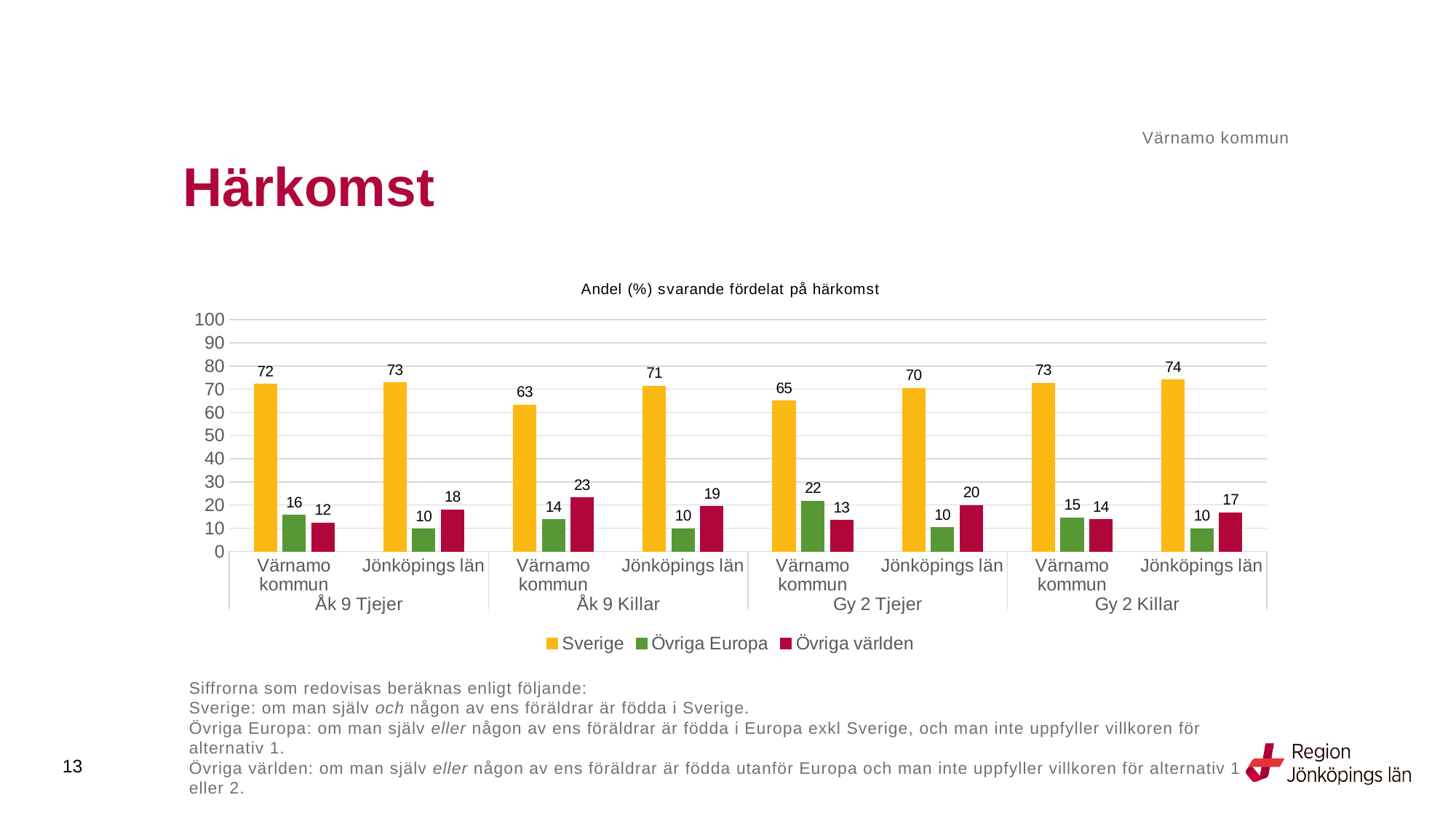
Which category has the lowest Sverige value? Värnamo kommun (Åk 9 Killar) What kind of chart is shown on the slide? bar chart How many series does the legend list? 3 What is the Sverige value for Värnamo kommun in the Åk 9 Killar group? 63 Which category has the highest Sverige value? Jönköpings län (Gy 2 Killar) What is the title of the chart? Andel (%) svarande fördelat på härkomst What is the difference between the Sverige values for Värnamo kommun and Jönköpings län in the Åk 9 Killar group? 8 What is the Övriga Europa value for Värnamo kommun in the Gy 2 Tjejer group? 22 What is the total of the three values for Värnamo kommun in the Gy 2 Killar group? 102 In the Åk 9 Tjejer group, is the Övriga Europa value for Värnamo kommun larger or smaller than its Övriga världen value? larger Which series is shown in yellow? Sverige What is the Övriga världen value for Jönköpings län in the Gy 2 Tjejer group? 20